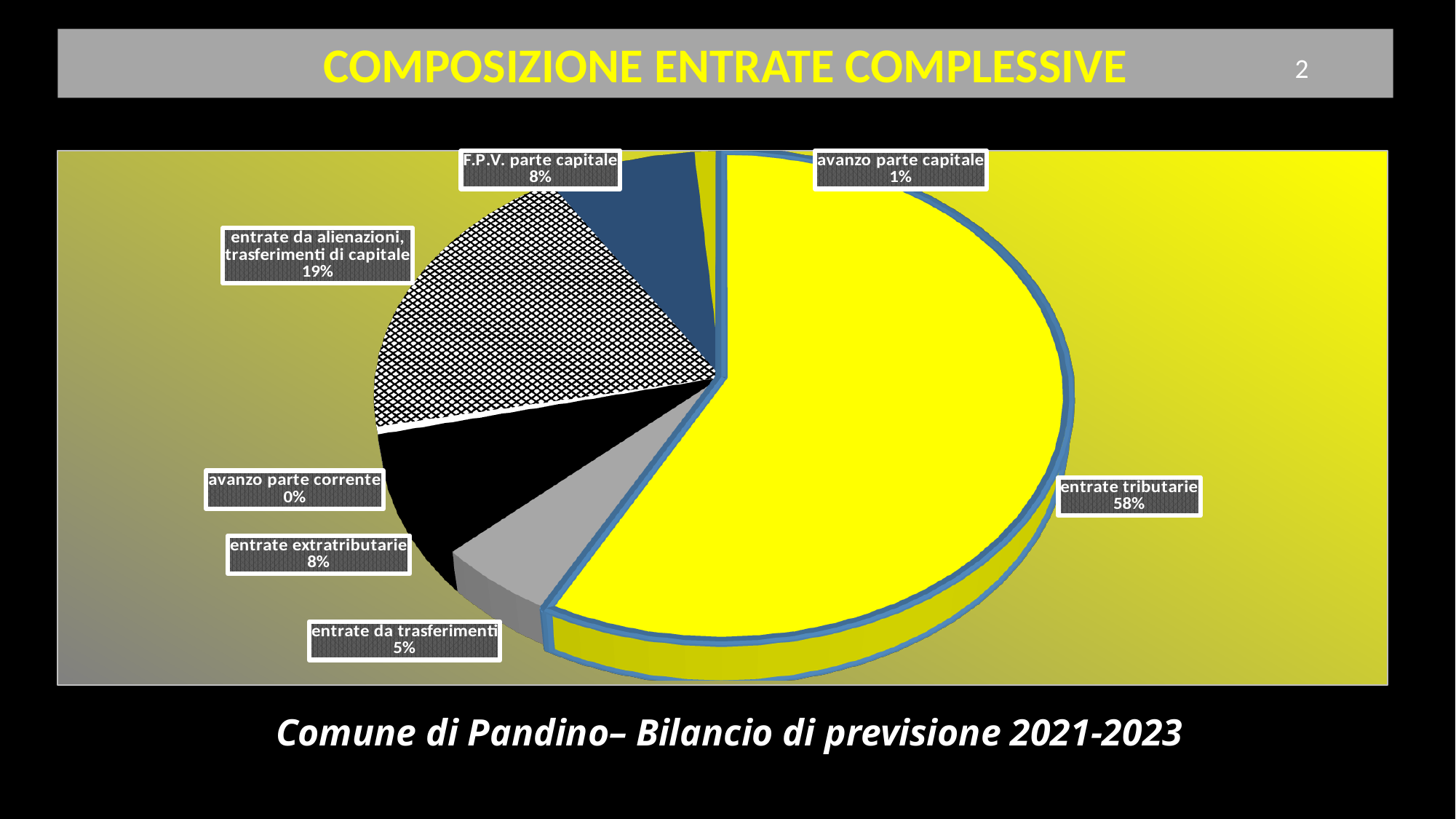
Which category has the smallest slice of the pie? avanzo parte corrente What kind of chart is shown on the slide? pie chart What is the value shown for "entrate da trasferimenti"? 5% Which is larger, "entrate extratributarie" or "entrate da trasferimenti"? entrate extratributarie What is the difference in percentage points between "entrate tributarie" and "entrate da alienazioni, trasferimenti di capitale"? 39 What is the title of the chart on the slide? COMPOSIZIONE ENTRATE COMPLESSIVE What share of the pie does "entrate tributarie" represent? 58% What share of the pie does "entrate da alienazioni, trasferimenti di capitale" represent? 19% What is the value shown for "avanzo parte corrente"? 0% How many slices (categories) are labelled on the pie chart? 7 What is the value shown for "avanzo parte capitale"? 1% Which category has the largest slice of the pie? entrate tributarie